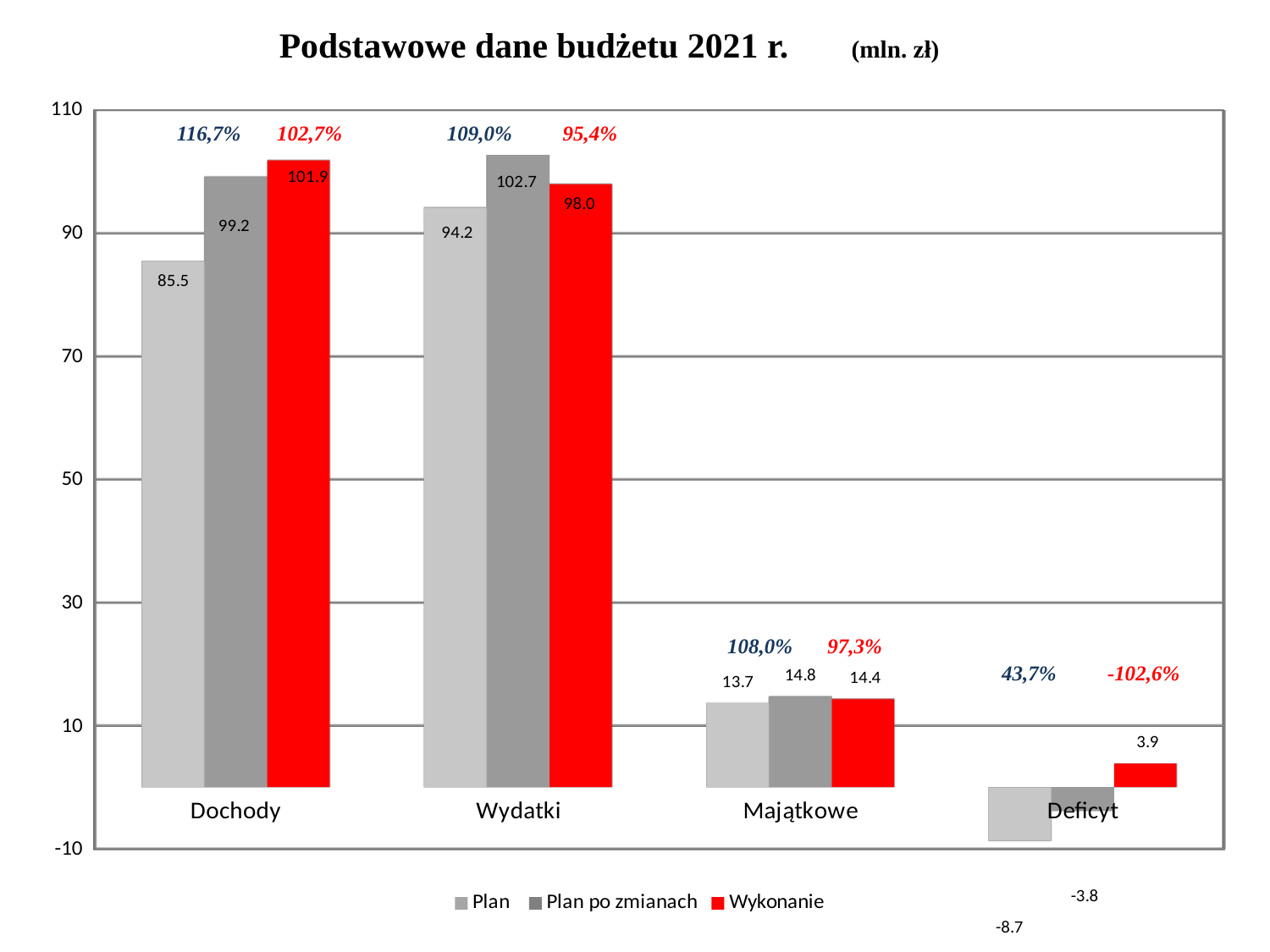
What is the Plan value for Wydatki? 94.2 Which category has the highest Plan po zmianach value? Wydatki How many series does the legend list? 3 How many categories are shown on the x axis? 4 Which is larger for Wydatki: the Plan po zmianach value or the Wykonanie value? Plan po zmianach What is the Wykonanie value for Dochody? 101.9 What is the Plan value for Deficyt? -8.7 What is the Plan po zmianach value for Majątkowe? 14.8 Which category has the lowest Wykonanie value? Deficyt What kind of chart is shown on the slide? Bar chart What is the title of the chart? Podstawowe dane budżetu 2021 r. (mln. zł) What is the difference between the Plan po zmianach and Plan values for Dochody? 13.7